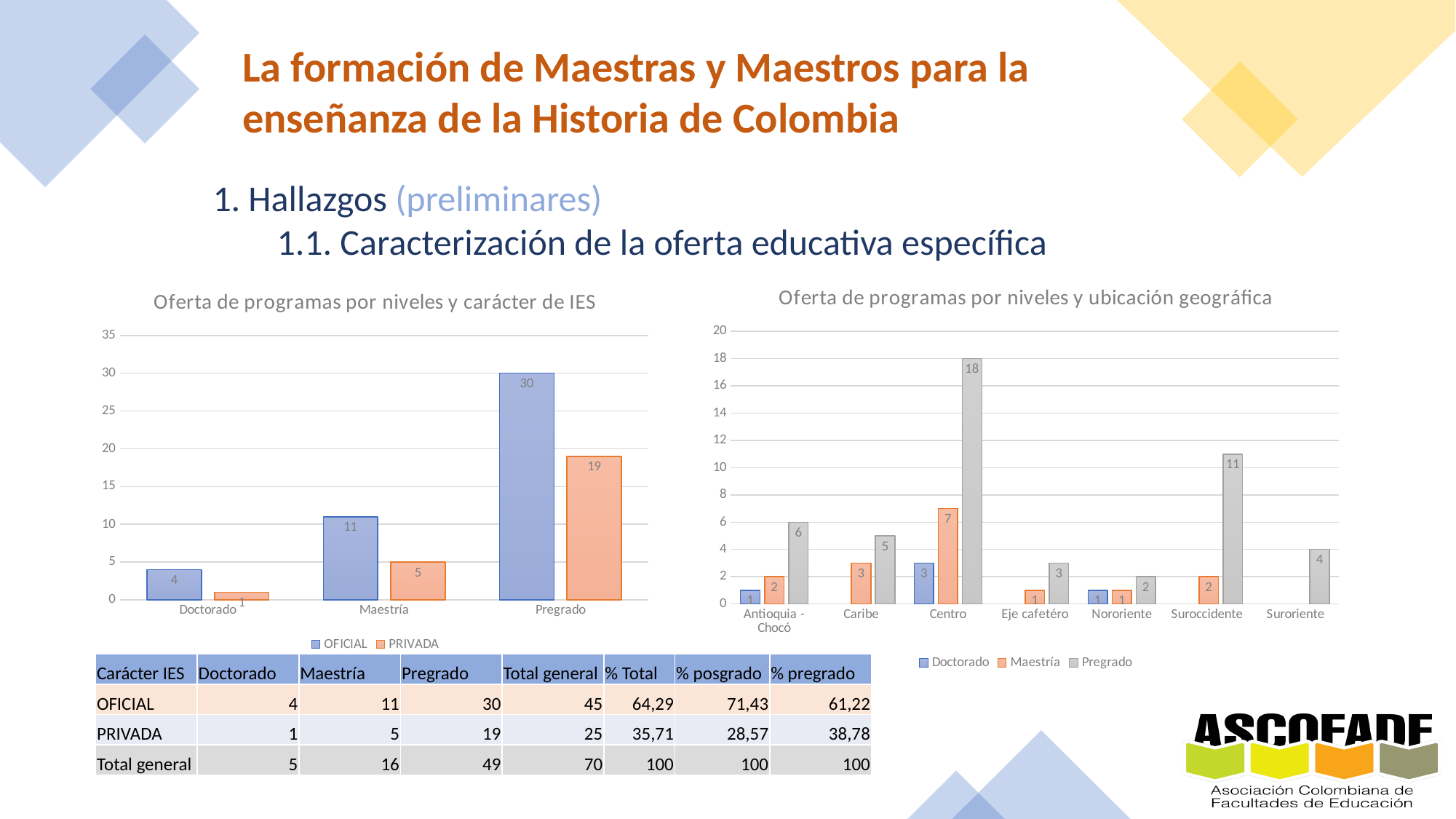
In the chart 'Oferta de programas por niveles y ubicación geográfica', what is the Maestría value for Caribe? 3 In the chart 'Oferta de programas por niveles y ubicación geográfica', which region has the highest Pregrado value? Centro In the chart 'Oferta de programas por niveles y carácter de IES', what is the PRIVADA value for Maestría? 5 In the chart 'Oferta de programas por niveles y ubicación geográfica', how many regions are shown on the x axis? 7 In the chart 'Oferta de programas por niveles y ubicación geográfica', which is larger: the Pregrado value for Suroccidente or the Pregrado value for Antioquia - Chocó? Suroccidente In the chart 'Oferta de programas por niveles y carácter de IES', what is the difference between the OFICIAL and PRIVADA values for Pregrado? 11 In the chart 'Oferta de programas por niveles y ubicación geográfica', what is the difference between the Pregrado values for Centro and Suroccidente? 7 What kind of chart is 'Oferta de programas por niveles y ubicación geográfica'? Bar chart In the chart 'Oferta de programas por niveles y carácter de IES', which level has the lowest PRIVADA value? Doctorado In the chart 'Oferta de programas por niveles y ubicación geográfica', what is the Pregrado value for Centro? 18 In the chart 'Oferta de programas por niveles y carácter de IES', what is the OFICIAL value for Pregrado? 30 In the chart 'Oferta de programas por niveles y carácter de IES', how many series does the legend list? 2